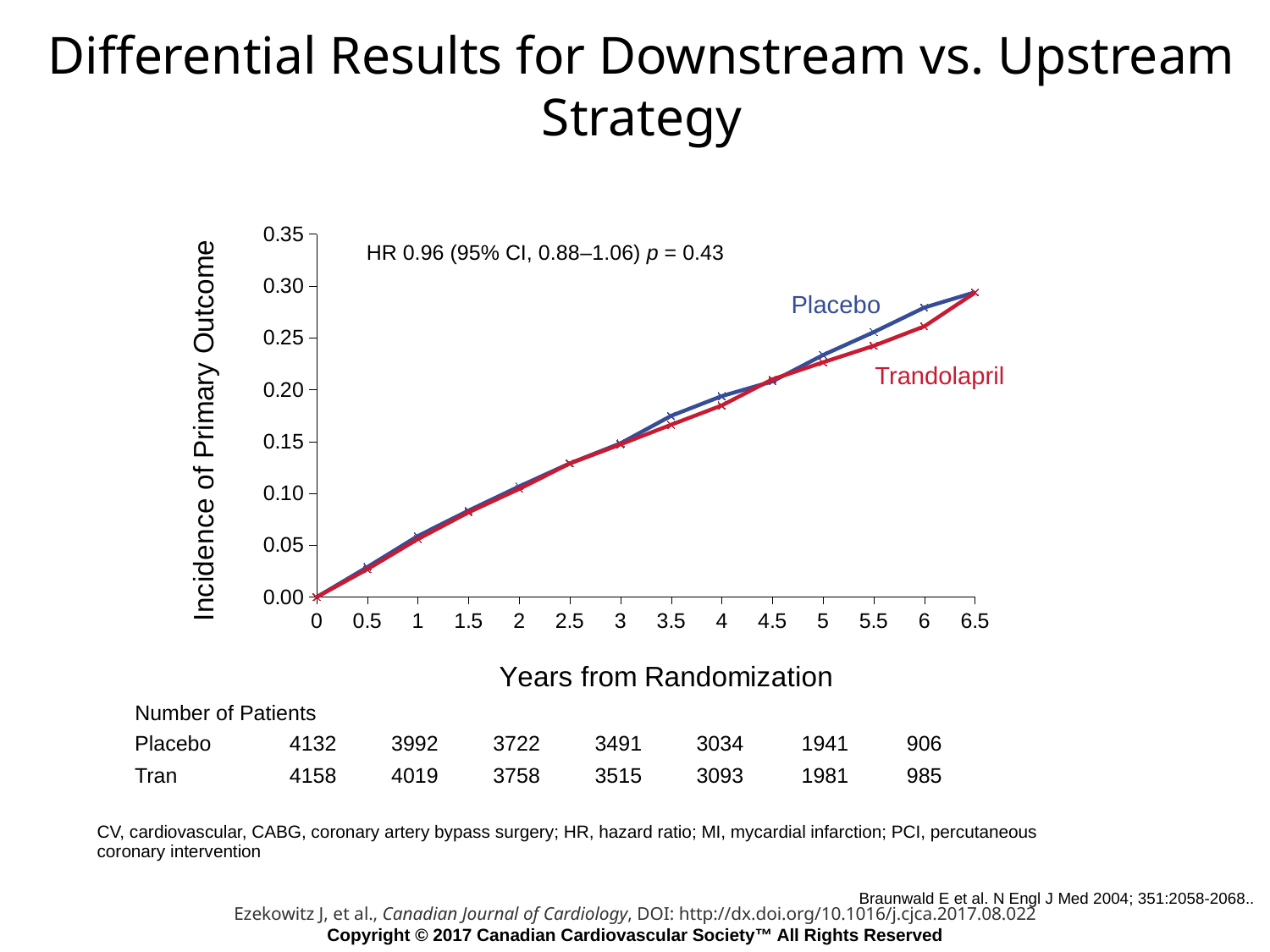
At 6 years from randomization, which series has the higher incidence of primary outcome, Placebo or Trandolapril? Placebo Is the value for Trandolapril at 5 years greater or less than 0.20? greater How many series are plotted in the chart? 2 Is the value for Placebo at 1 year greater or less than 0.05? greater How many tick marks are shown on the x axis from 0 to 6.5 years? 14 Is the value for Placebo at 6 years greater or less than 0.25? greater What is the label of the y axis? Incidence of Primary Outcome Do the incidence values for Trandolapril rise or fall as years from randomization increase? rise Which series is drawn in blue? Placebo What kind of chart is shown on the slide? line chart What is the incidence of primary outcome for Placebo at 0 years from randomization? 0.00